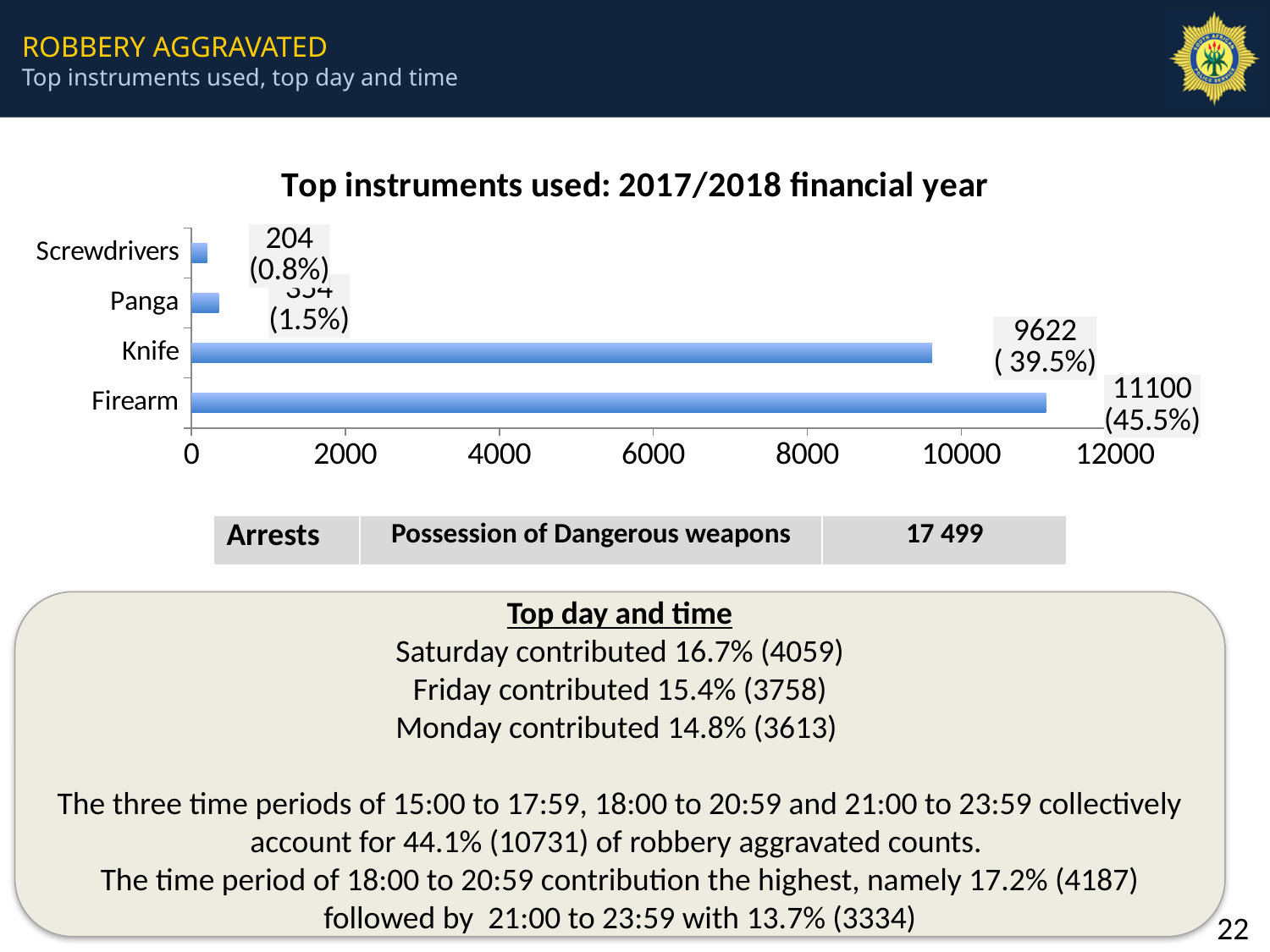
What is the difference between the values for Firearm and Knife? 1478 Is the value for Knife greater or less than 8000? greater What percentage share is shown for Firearm in the chart? 45.5% What kind of chart is used to show the top instruments used? bar chart What is the value for Screwdrivers in the Top instruments used chart? 204 What is the value for Knife in the Top instruments used chart? 9622 How many instrument categories are shown in the chart? 4 Which instrument has the lowest value in the chart? Screwdrivers What is the value for Firearm in the Top instruments used chart? 11100 Which instrument has the highest value in the chart? Firearm Which has a larger value, Knife or Panga? Knife Is the value for Panga greater or less than 2000? less